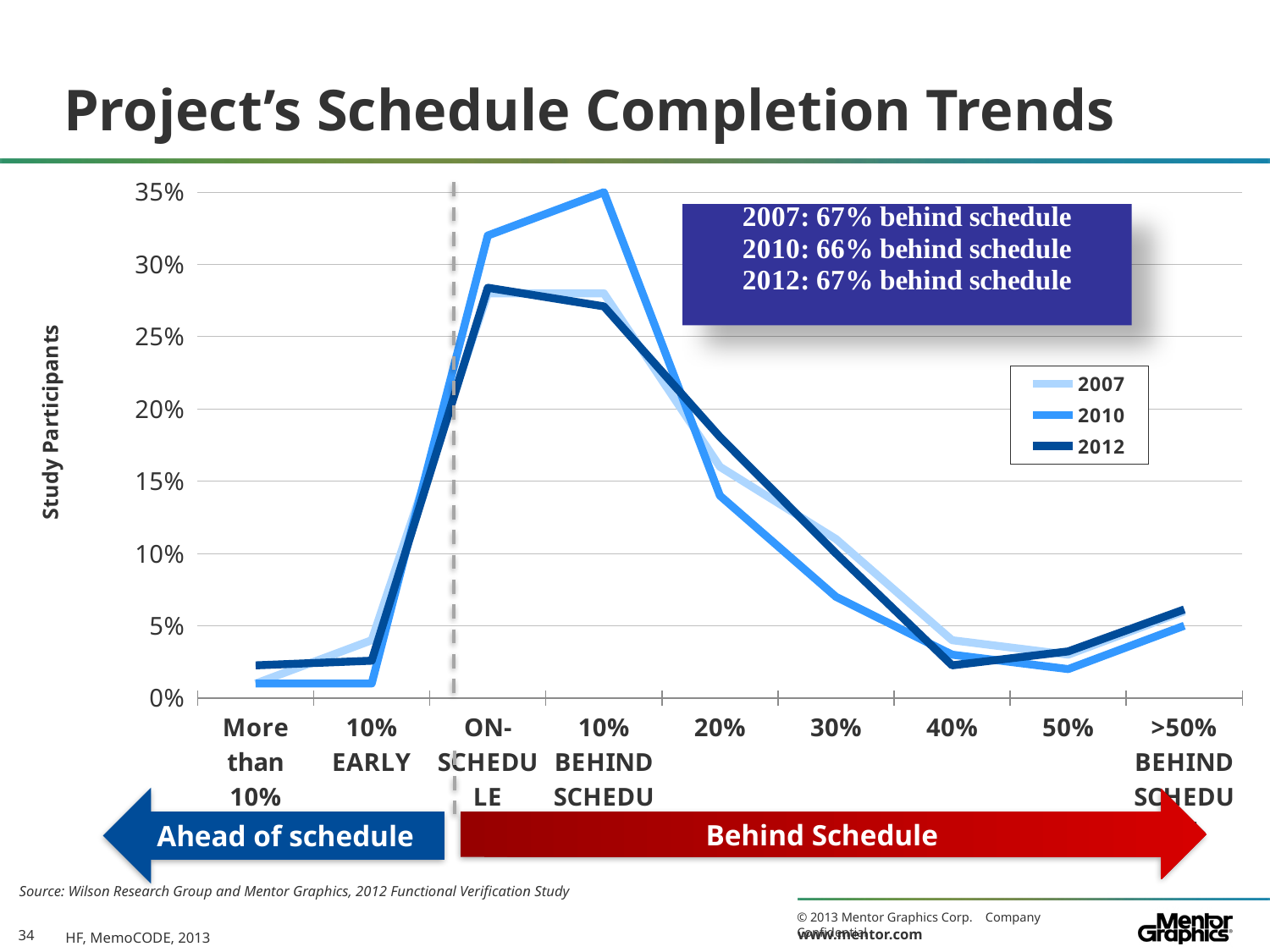
According to the text box on the chart, what percentage of projects were behind schedule in 2010? 66% How many categories are shown along the x axis? 9 Do the values of the 2010 series rise or fall from 10% behind schedule to 50% behind schedule? fall Is the value for 2012 at 40% behind schedule greater or less than 5%? less What kind of chart is shown on the slide? line chart Is the value for 2010 at 30% behind schedule greater or less than 10%? less At which category does the 2010 series reach its highest value? 10% behind schedule Is the value for 2010 at On-schedule greater or less than 30%? greater How many series does the legend list? 3 At 10% behind schedule, which series has the larger value, 2010 or 2012? 2010 At which category does the 2012 series reach its highest value? On-schedule At 20% behind schedule, which series has the larger value, 2010 or 2012? 2012